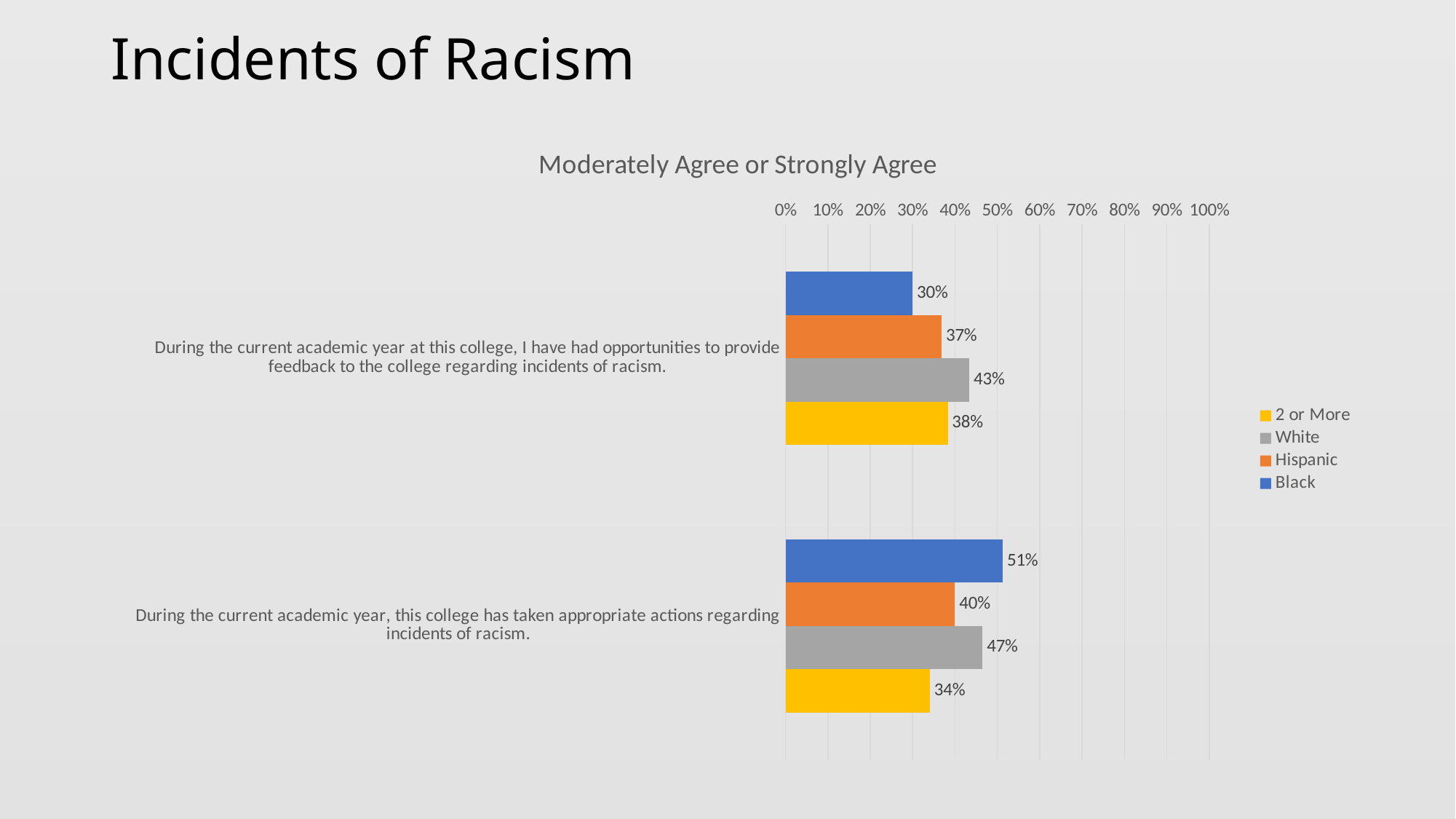
What is the value for Black on the statement about having opportunities to provide feedback regarding incidents of racism? 30% What kind of chart is shown on the slide? Bar chart What is the value for 2 or More on the statement about having opportunities to provide feedback regarding incidents of racism? 38% Which group has the lowest value on the statement about having opportunities to provide feedback regarding incidents of racism? Black How many series does the legend list? 4 What is the value for White on the statement that the college has taken appropriate actions regarding incidents of racism? 47% How many statements (categories) are shown on the chart? 2 Is the Black value on the statement that the college has taken appropriate actions greater or less than 50%? greater What is the difference between the Black and 2 or More values on the statement that the college has taken appropriate actions regarding incidents of racism? 17% Which group has the highest value on the statement that the college has taken appropriate actions regarding incidents of racism? Black Which is larger on the statement about having opportunities to provide feedback: the Hispanic value or the White value? White What is the title of the chart? Moderately Agree or Strongly Agree